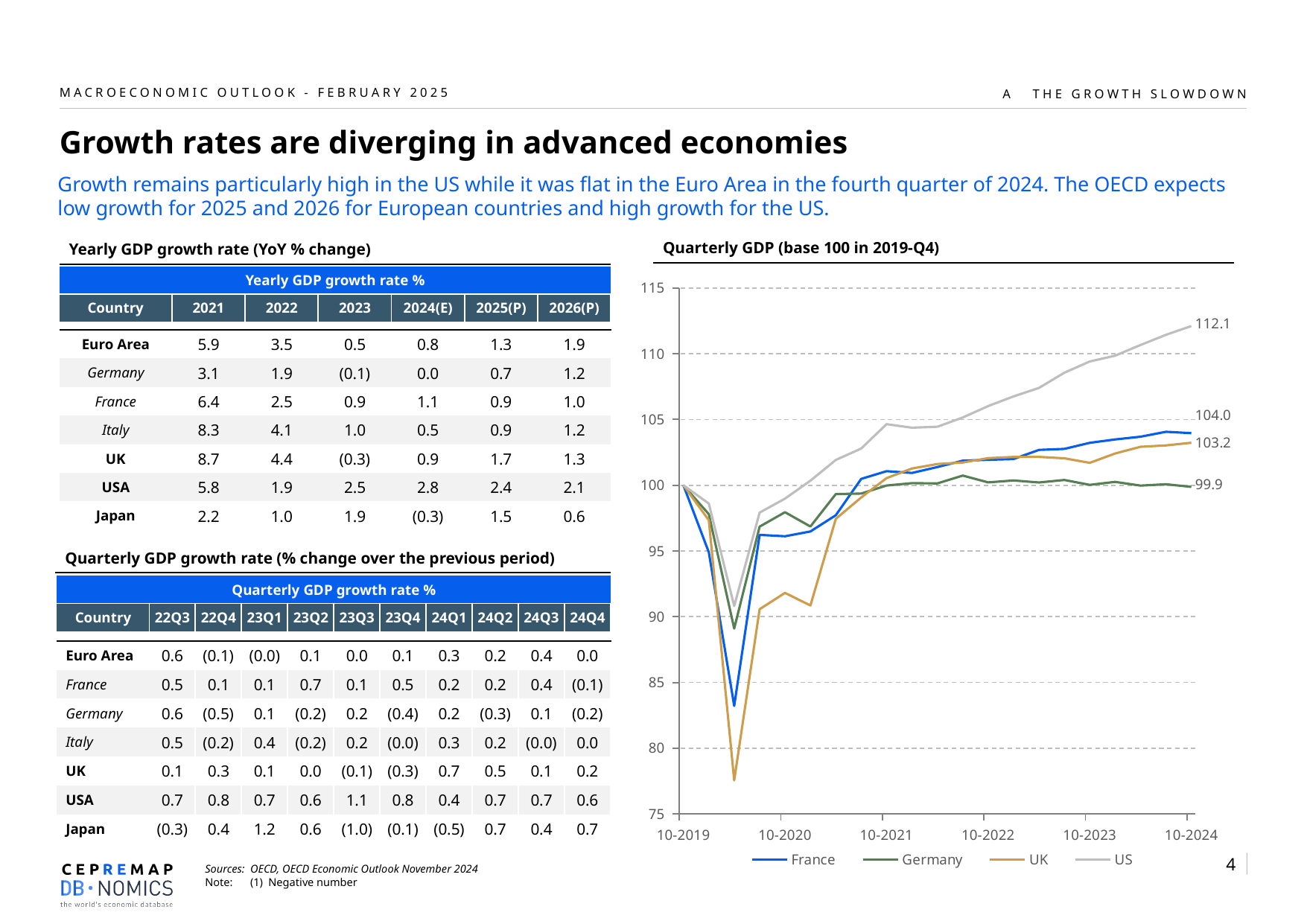
In the Quarterly GDP chart, which has the higher final labelled value, France or the UK? France In the Quarterly GDP chart, what is the final labelled value for Germany? 99.9 In the Quarterly GDP chart, does the US line rise or fall between 10-2021 and 10-2024? rise In the Quarterly GDP chart, is the value for the UK at 10-2020 greater or less than 95? less In the Quarterly GDP chart, what is the final labelled value for the US? 112.1 In the Quarterly GDP chart, which country has the lowest value at the end of the series? Germany In the Quarterly GDP chart, what is the final labelled value for the UK? 103.2 In the Quarterly GDP chart, which country has the highest value at the end of the series? US In the Quarterly GDP chart, what is the final labelled value for France? 104.0 What kind of chart is the "Quarterly GDP (base 100 in 2019-Q4)" chart? line chart In the Quarterly GDP chart, what is the difference between the final labelled values for the US and Germany? 12.2 How many series does the legend of the Quarterly GDP chart list? 4